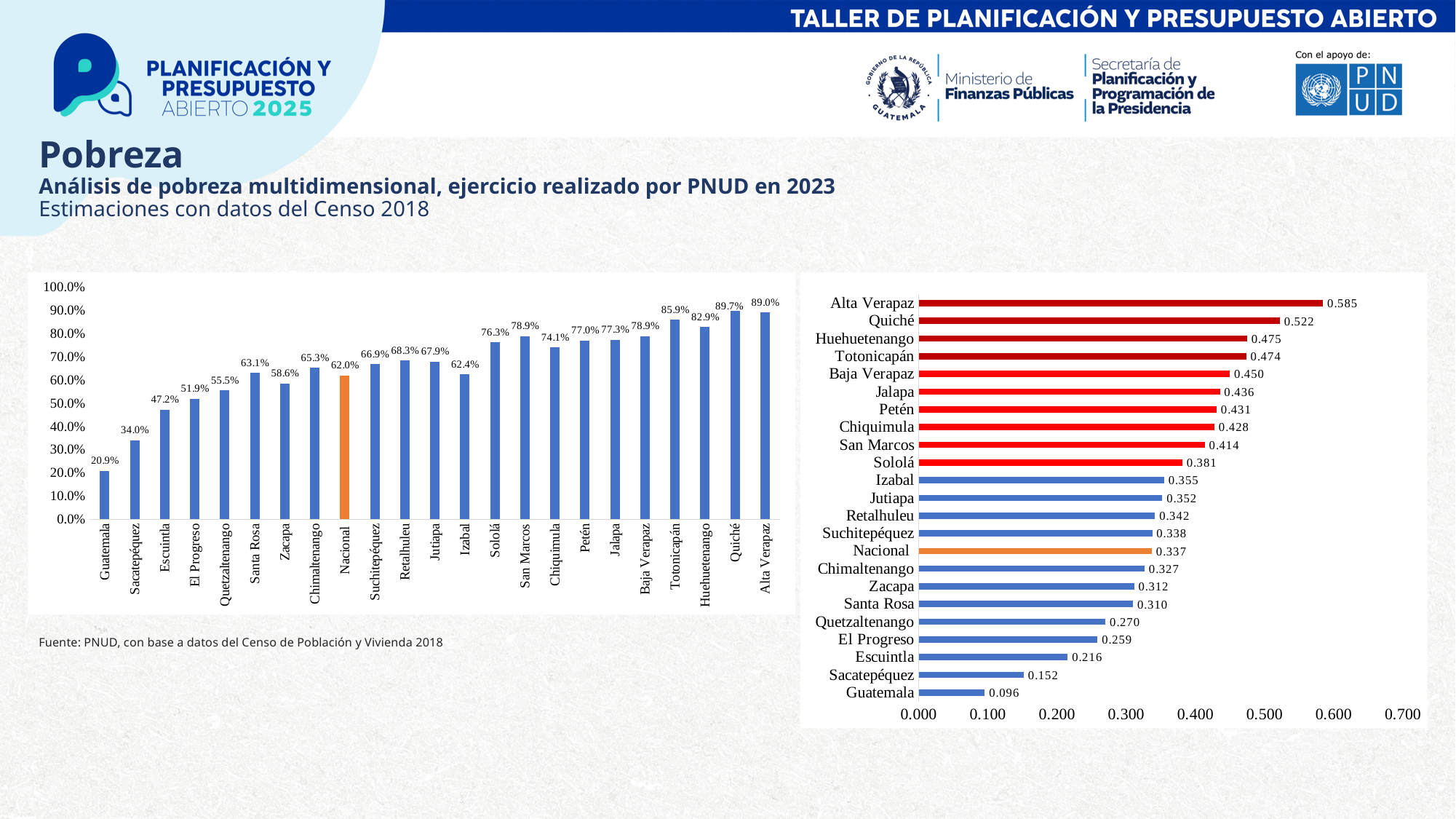
In the right chart, which category has the lowest value? Guatemala In the right chart, what is the value for Nacional? 0.337 What kind of chart is the chart on the right? Bar chart In the left chart, what is the value for Nacional? 62.0% In the left chart, which category has the highest value? Quiché How many bars are plotted in the left chart? 23 In the left chart, what is the difference between Quiché and Guatemala? 68.8% In the right chart, what is the value for Alta Verapaz? 0.585 In the right chart, which bar is coloured orange? Nacional In the right chart, what is the difference between Alta Verapaz and Quiché? 0.063 In the left chart, what is the value for Guatemala? 20.9% In the left chart, which is larger, Totonicapán or Huehuetenango? Totonicapán